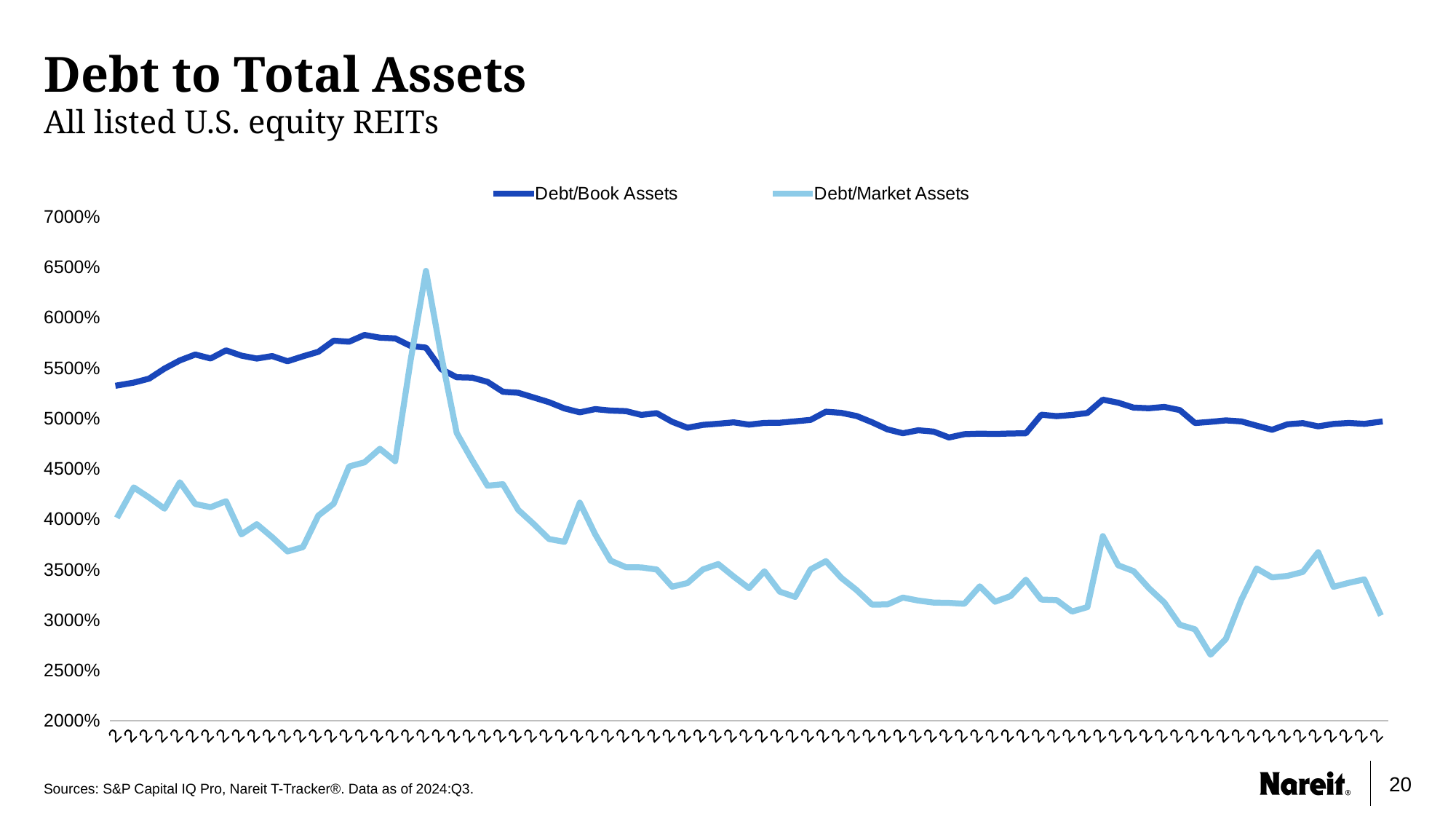
Is the lowest value of the Debt/Market Assets line greater or less than 3000%? less Is the peak value of the Debt/Market Assets line greater or less than 6000%? greater What is the title of the chart? Debt to Total Assets Which series has the lowest point on the chart? Debt/Market Assets At the right end of the chart, which series is higher, Debt/Book Assets or Debt/Market Assets? Debt/Book Assets How many series does the legend list? 2 What are the two series named in the legend? Debt/Book Assets and Debt/Market Assets Overall, does the Debt/Market Assets line rise or fall from the left end of the chart to the right end? fall Which series reaches the highest point on the chart? Debt/Market Assets Overall, does the Debt/Book Assets line rise or fall from the left end of the chart to the right end? fall Is the highest value of the Debt/Book Assets line greater or less than 5500%? greater What kind of chart is shown on the slide? line chart